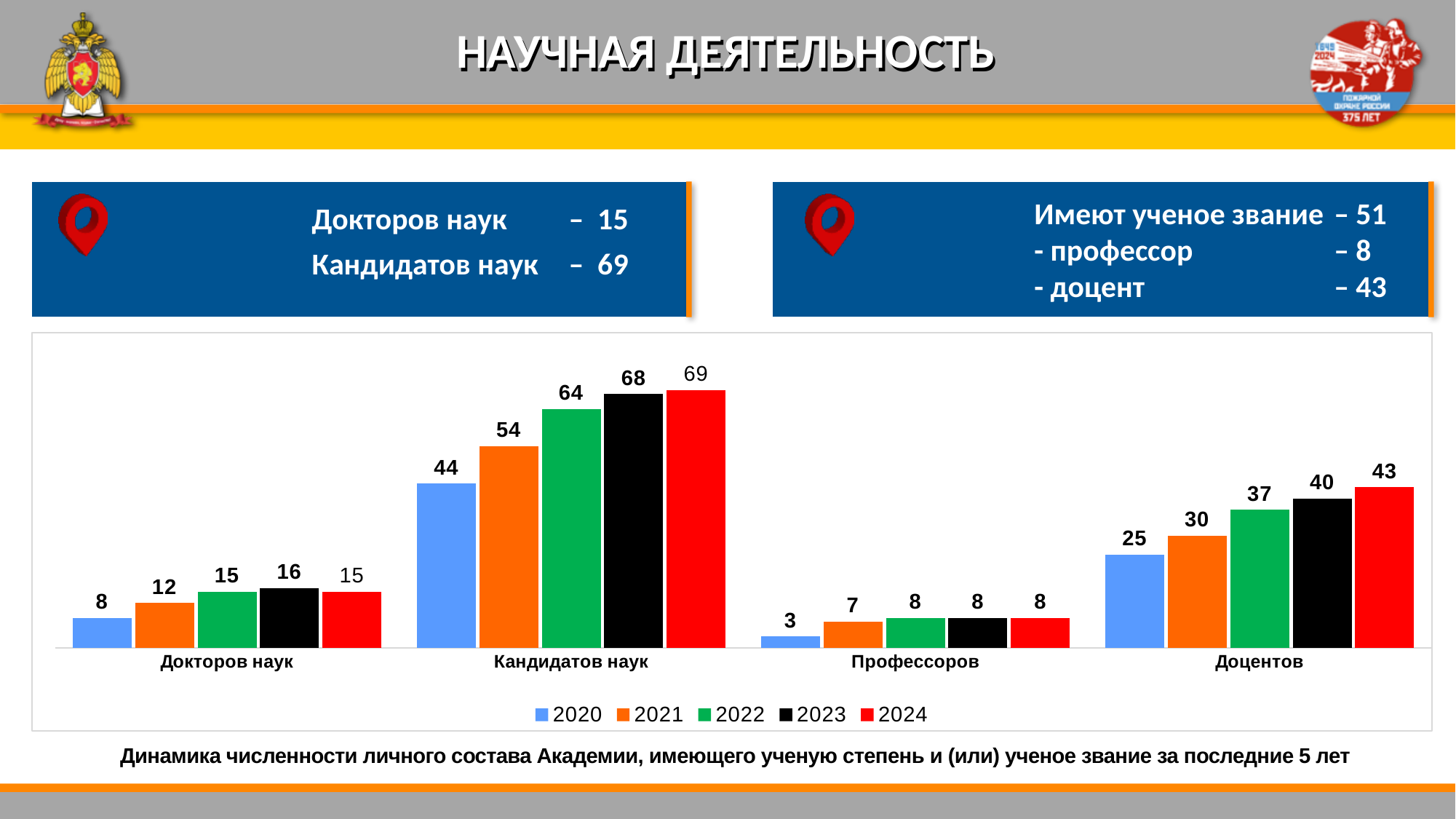
Which is larger: Докторов наук in 2023 or Докторов наук in 2024? Докторов наук in 2023 What kind of chart is shown on the slide? Bar chart How many series does the legend list? 5 Which category has the highest value in 2024? Кандидатов наук What is the value for Доцентов in 2020? 25 What is the difference between the 2023 and 2021 values for Доцентов? 10 What is the value for Кандидатов наук in 2022? 64 How many categories are shown on the x axis? 4 Which category has the lowest value in 2020? Профессоров Which colour represents the 2023 series in the legend? Black What is the difference between the 2024 and 2020 values for Кандидатов наук? 25 What is the value for Профессоров in 2021? 7